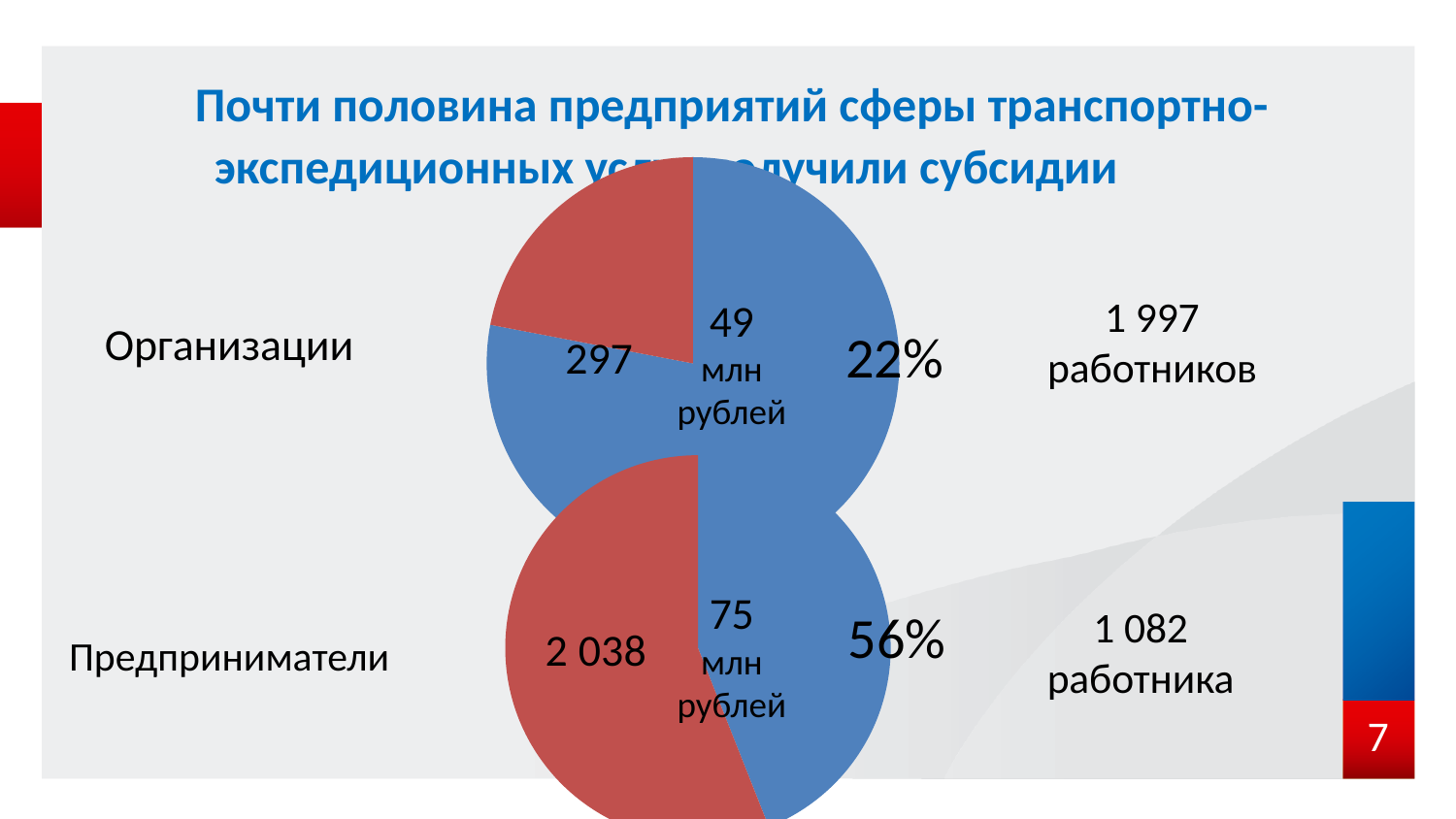
In the Предприниматели pie chart, what percentage is printed next to the chart? 56% How many pie charts are on the slide? 2 In the Организации pie chart, what percentage is printed next to the chart? 22% What amount in million rubles is printed in the Организации pie chart? 49 млн рублей How many workers are listed for Организации? 1 997 работников How many workers are listed for Предприниматели? 1 082 работника What amount in million rubles is printed in the Предприниматели pie chart? 75 млн рублей Which pie chart has the larger red slice, Организации or Предприниматели? Предприниматели What number is printed on the Предприниматели pie chart? 2 038 What kind of chart is used for the Организации row? pie chart How many slices does each pie chart have? 2